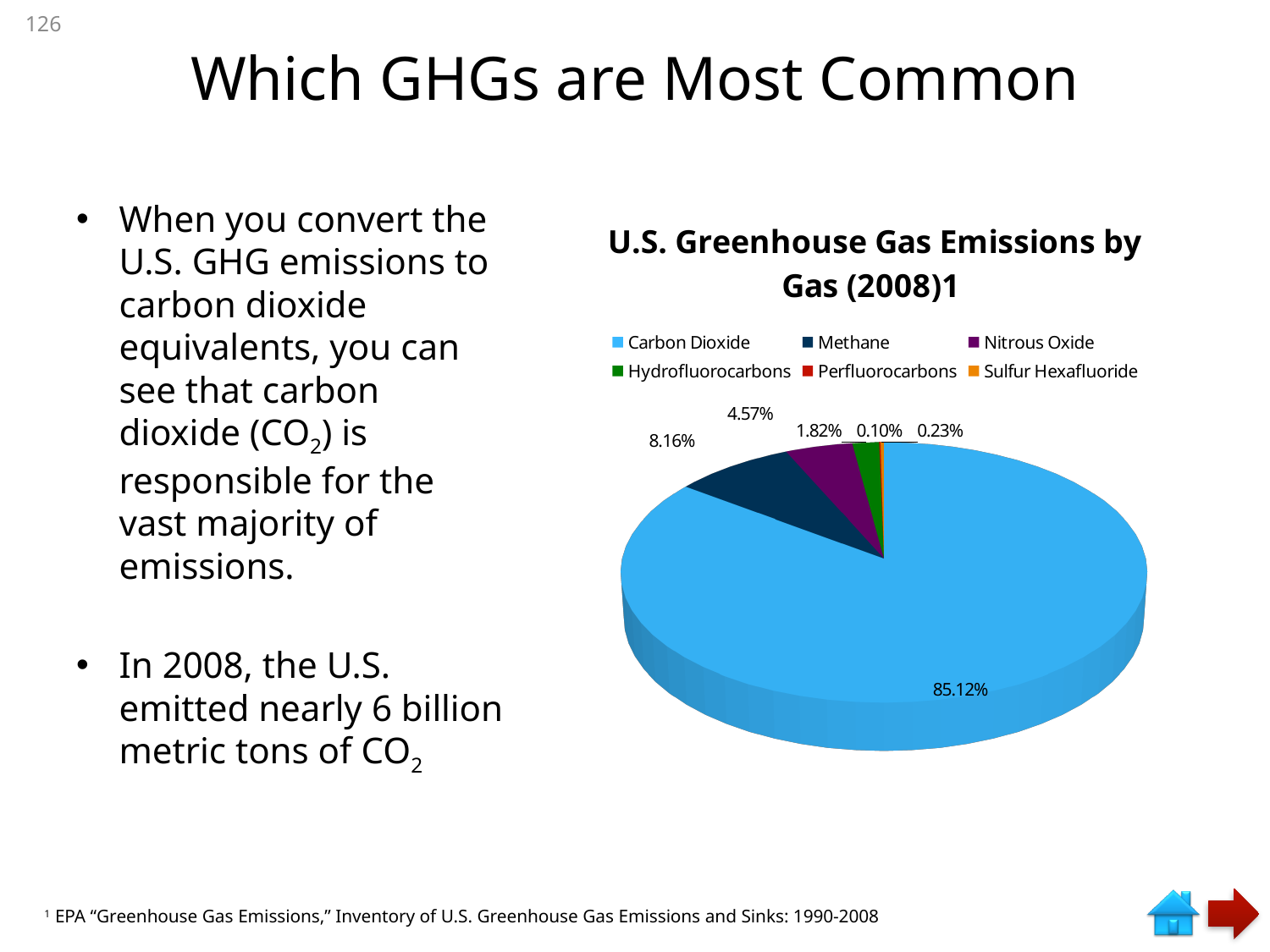
Which has a larger share, Methane or Hydrofluorocarbons? Methane How many gases does the legend list? 6 What type of chart is shown on the slide? Pie chart What is the difference in percentage points between the Methane and Nitrous Oxide shares? 3.59 What share of emissions is Nitrous Oxide? 4.57% What share of emissions is Sulfur Hexafluoride? 0.23% Which gas has the largest share of emissions? Carbon Dioxide Which gas has the smallest share of emissions? Perfluorocarbons What share of emissions is Methane? 8.16% What is the title of the chart? U.S. Greenhouse Gas Emissions by Gas (2008)1